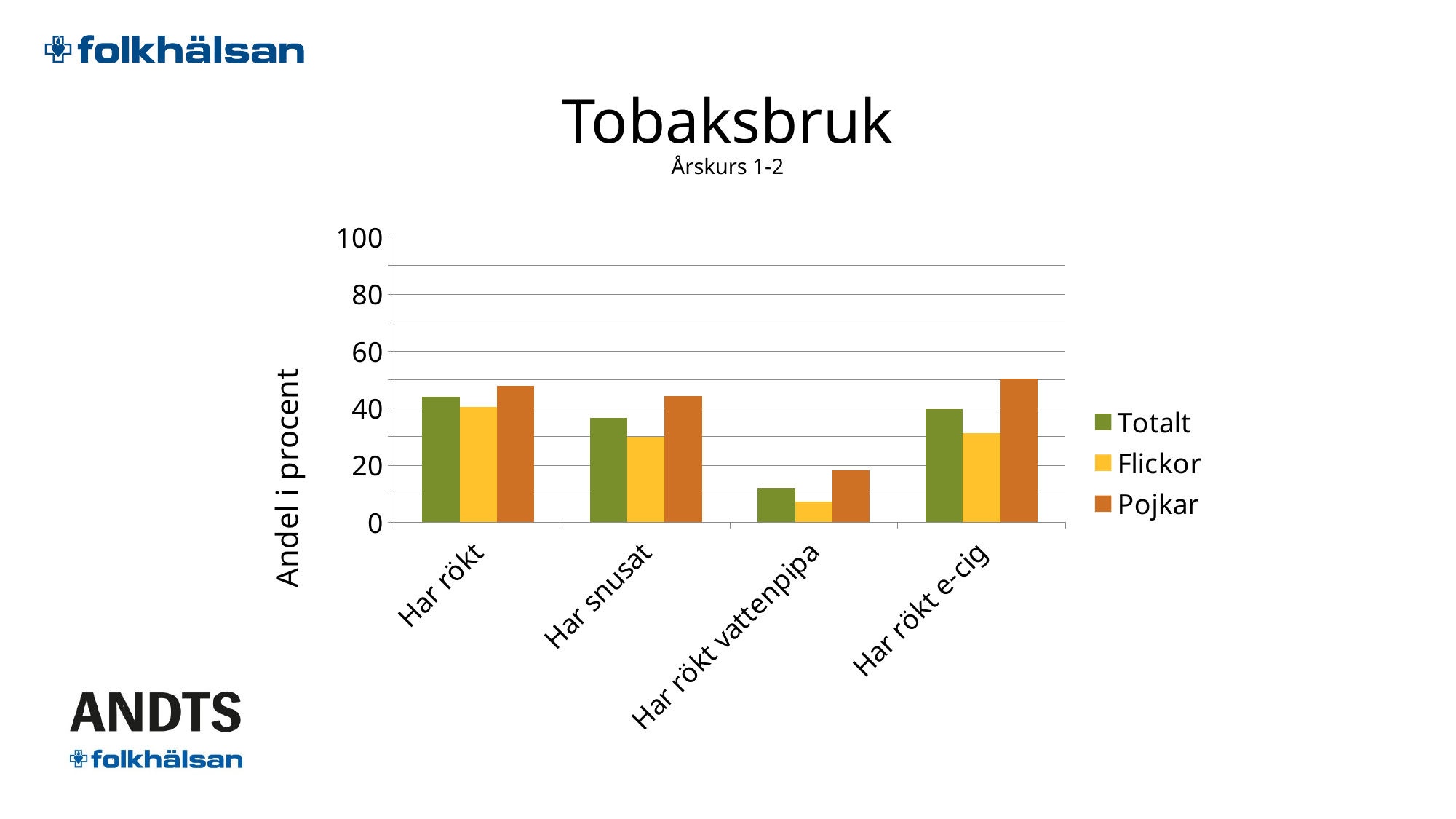
Is the value for Totalt in the 'Har snusat' category greater or less than 40? less In the 'Har rökt vattenpipa' category, which series has the highest bar? Pojkar Which category has the lowest value for the Totalt series? Har rökt vattenpipa What kind of chart is shown on the slide? bar chart What are the three entries listed in the chart legend? Totalt, Flickor, Pojkar Which category has the highest value for the Flickor series? Har rökt Is the value for Pojkar in the 'Har rökt e-cig' category greater or less than 40? greater Is the value for Flickor in the 'Har rökt vattenpipa' category greater or less than 20? less How many series does the legend list? 3 In the 'Har rökt e-cig' category, which is larger: the value for Pojkar or the value for Flickor? Pojkar What is the label on the vertical axis of the chart? Andel i procent How many categories are shown on the x axis of the chart? 4